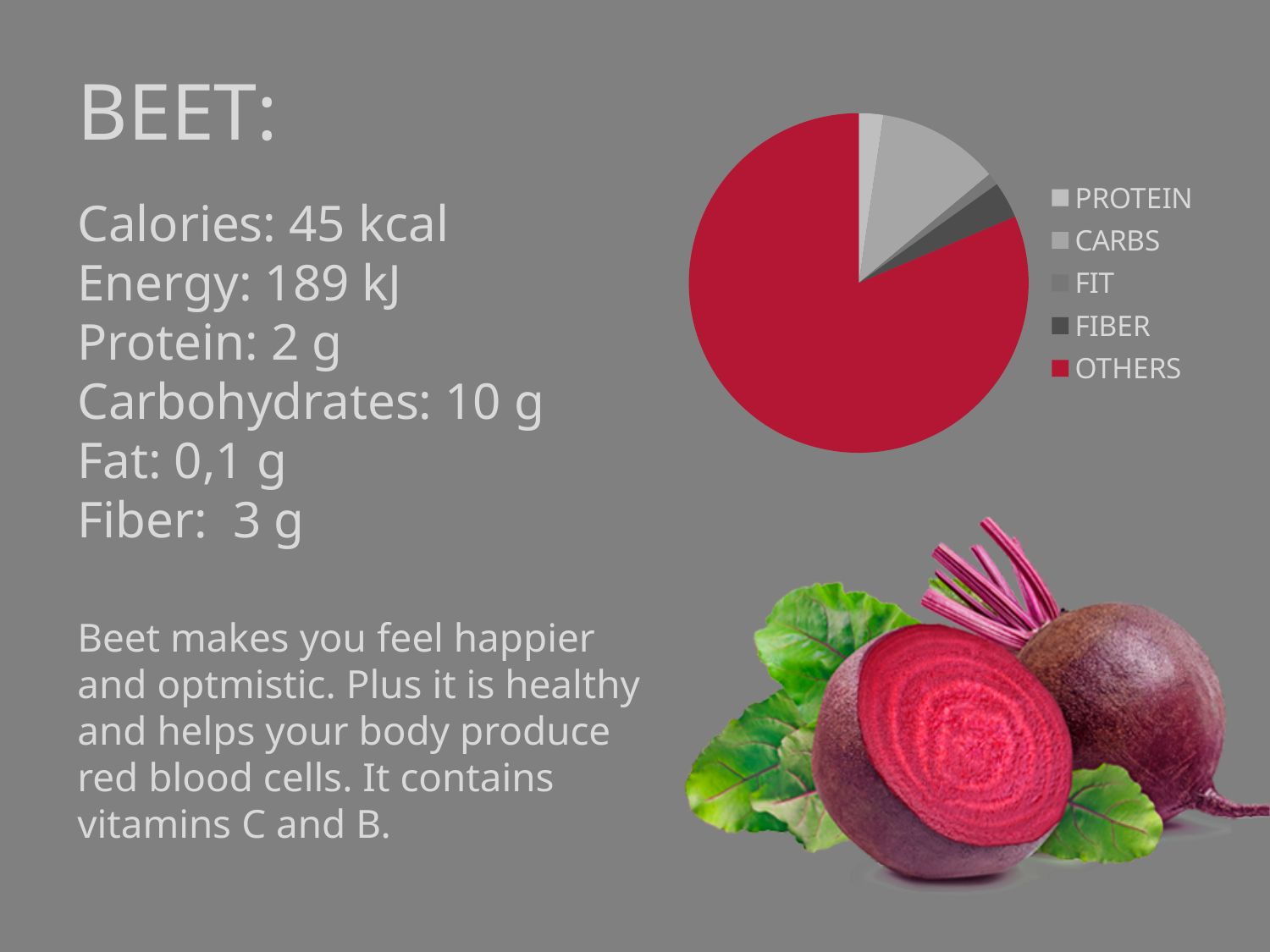
Which slice is larger in the pie chart, CARBS or PROTEIN? CARBS Which slice is larger in the pie chart, OTHERS or CARBS? OTHERS What colour is the OTHERS slice in the pie chart? red Does the OTHERS slice take up more or less than half of the pie chart? more What kind of chart is shown on the slide? pie chart Which slice is larger in the pie chart, CARBS or FIBER? CARBS Which category has the largest slice in the pie chart? OTHERS Which legend entry is listed last in the pie chart's legend? OTHERS How many slices does the pie chart have? 5